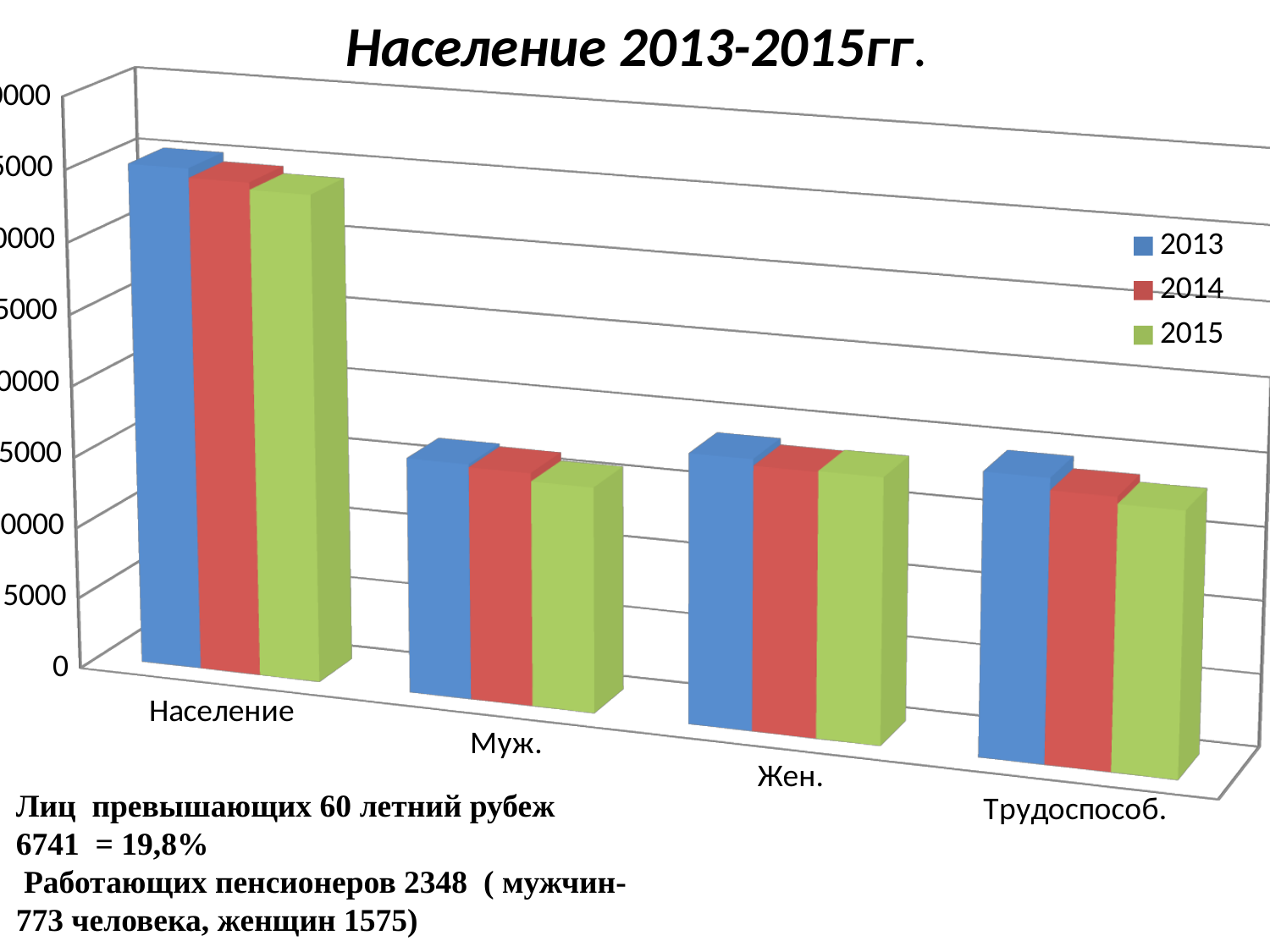
Is the value for Трудоспособ. in 2015 greater or less than 20000? less Is the value for Жен. in 2015 greater or less than 10000? greater What is the title of the chart? Население 2013-2015гг. Is the value for Население in 2013 greater or less than 30000? greater Do the values for Население rise or fall from 2013 to 2015? fall Which years are listed in the legend? 2013, 2014, 2015 How many series does the legend list? 3 How many categories are shown on the x axis? 4 Which is larger: the 2013 value for Население or the 2013 value for Муж.? Население What kind of chart is shown on the slide? bar chart Which category has the highest bars? Население